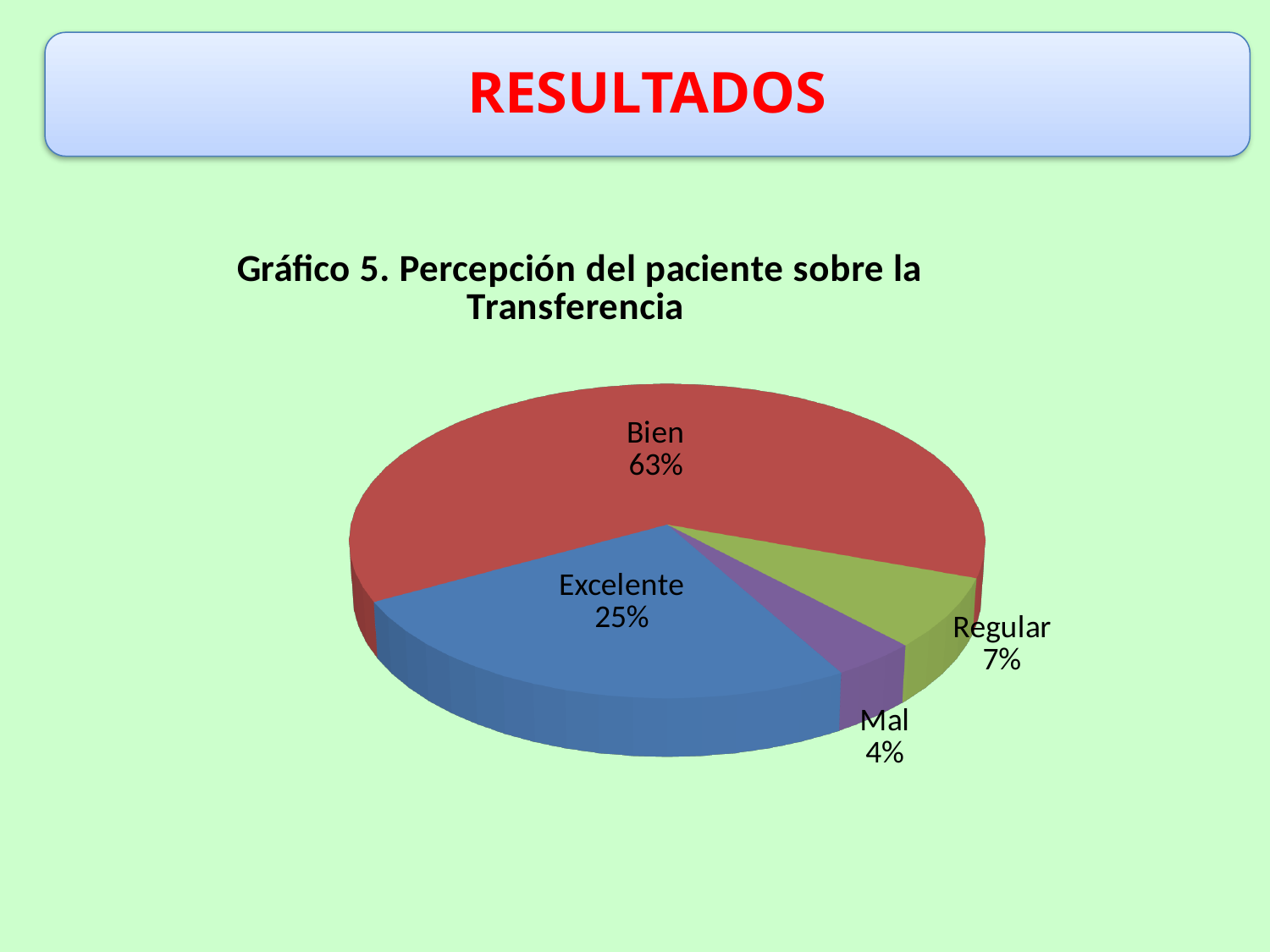
What is the difference in percentage points between Bien and Excelente? 38 How many categories are shown in the pie chart? 4 What is the title of the chart? Gráfico 5. Percepción del paciente sobre la Transferencia What kind of chart is shown on the slide? Pie chart Which is larger, the share for Regular or the share for Mal? Regular What percentage of patients rated the transfer as Mal? 4% What percentage of patients rated the transfer as Bien? 63% Which category has the largest share of the pie? Bien What percentage of patients rated the transfer as Regular? 7% What colour is the slice for Excelente? Blue What percentage of patients rated the transfer as Excelente? 25% Which category has the smallest share of the pie? Mal